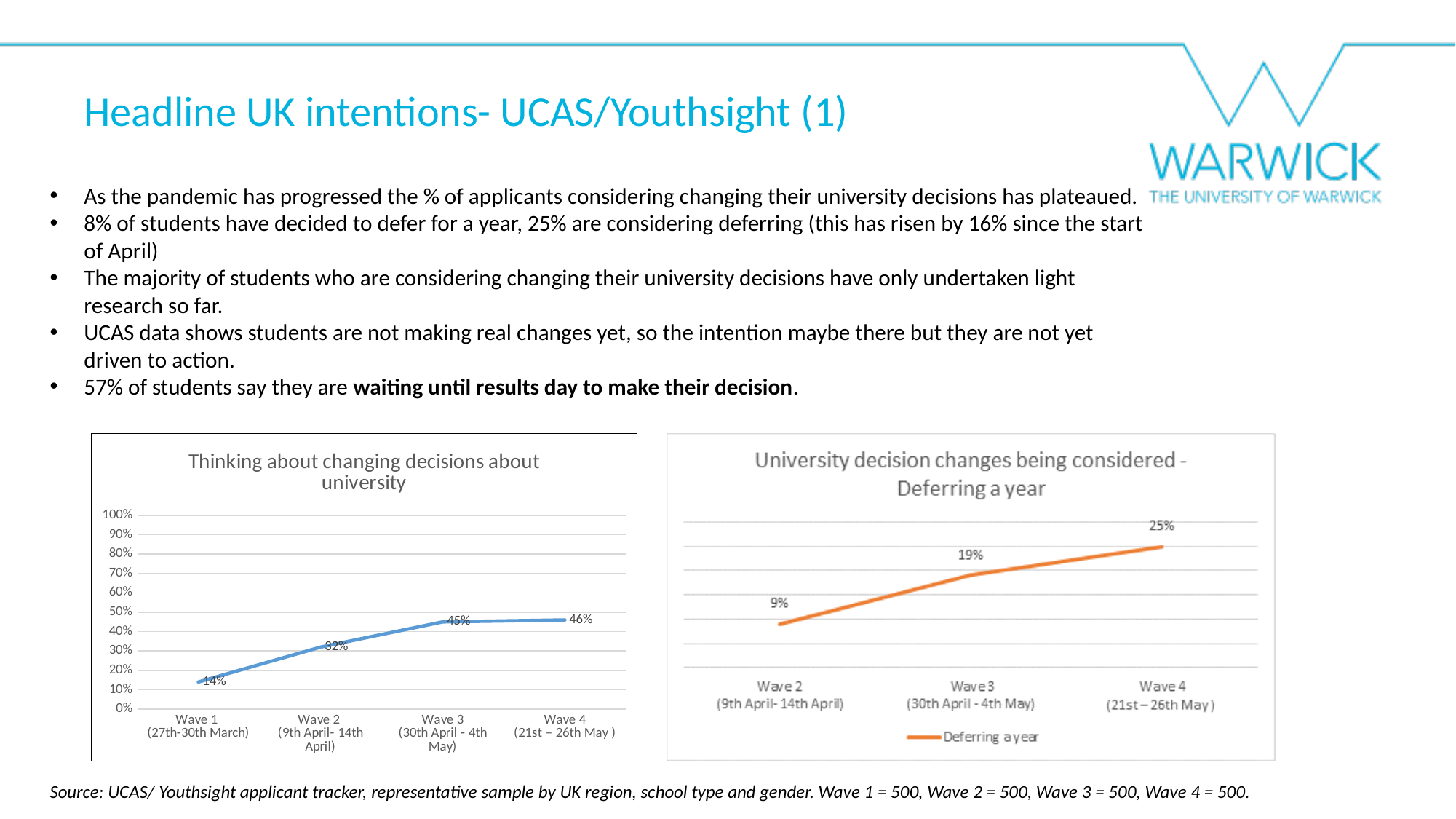
In the 'Thinking about changing decisions about university' chart, what is the value for Wave 1? 14% In the 'Thinking about changing decisions about university' chart, which wave has the highest value? Wave 4 In the 'Thinking about changing decisions about university' chart, do the values rise or fall from Wave 1 to Wave 4? rise In the 'Thinking about changing decisions about university' chart, which wave has the lowest value? Wave 1 In the 'Thinking about changing decisions about university' chart, what is the value for Wave 3? 45% In the 'University decision changes being considered - Deferring a year' chart, what is the value for Wave 3? 19% In the 'University decision changes being considered - Deferring a year' chart, what series does the legend list? Deferring a year In the 'Thinking about changing decisions about university' chart, how many waves are plotted? 4 What kind of chart is the 'University decision changes being considered - Deferring a year' chart? line chart In the 'Thinking about changing decisions about university' chart, what is the difference between Wave 2 and Wave 1? 18% In the 'University decision changes being considered - Deferring a year' chart, which wave has the lowest value? Wave 2 In the 'University decision changes being considered - Deferring a year' chart, what is the difference between Wave 4 and Wave 2? 16%